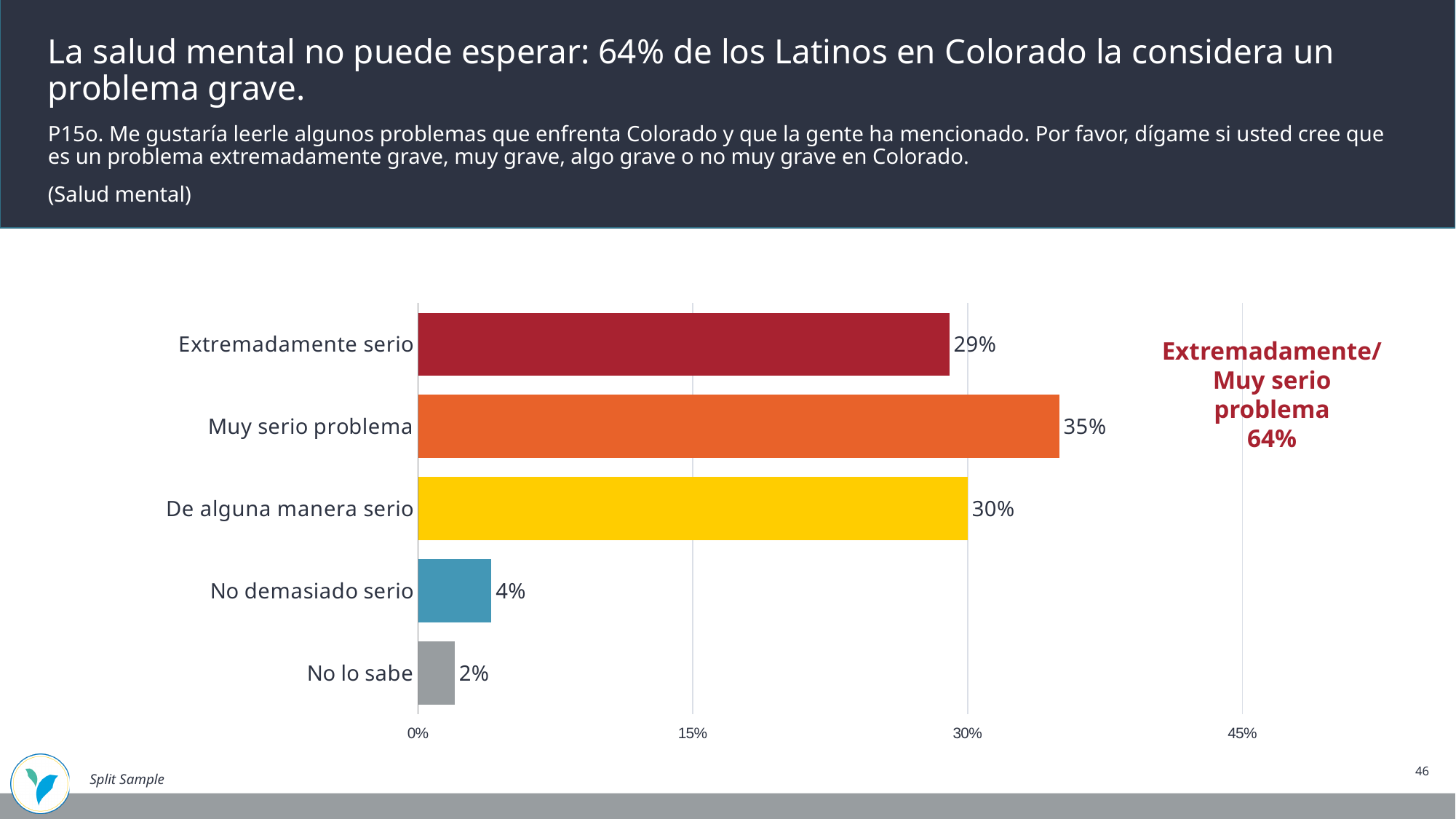
What is the value for "No lo sabe"? 2% What kind of chart is shown on the slide? Bar chart How many categories are shown in the chart? 5 What combined percentage is shown in the callout text for "Extremadamente/Muy serio problema"? 64% Which category has the lowest value? No lo sabe What is the difference between "Muy serio problema" and "Extremadamente serio"? 6% What colour is the bar for "De alguna manera serio"? Yellow What is the value for "Extremadamente serio"? 29% Is the value for "Extremadamente serio" greater or less than 15%? greater What is the value for "Muy serio problema"? 35% Which is larger, "De alguna manera serio" or "No demasiado serio"? De alguna manera serio Which category has the highest value? Muy serio problema